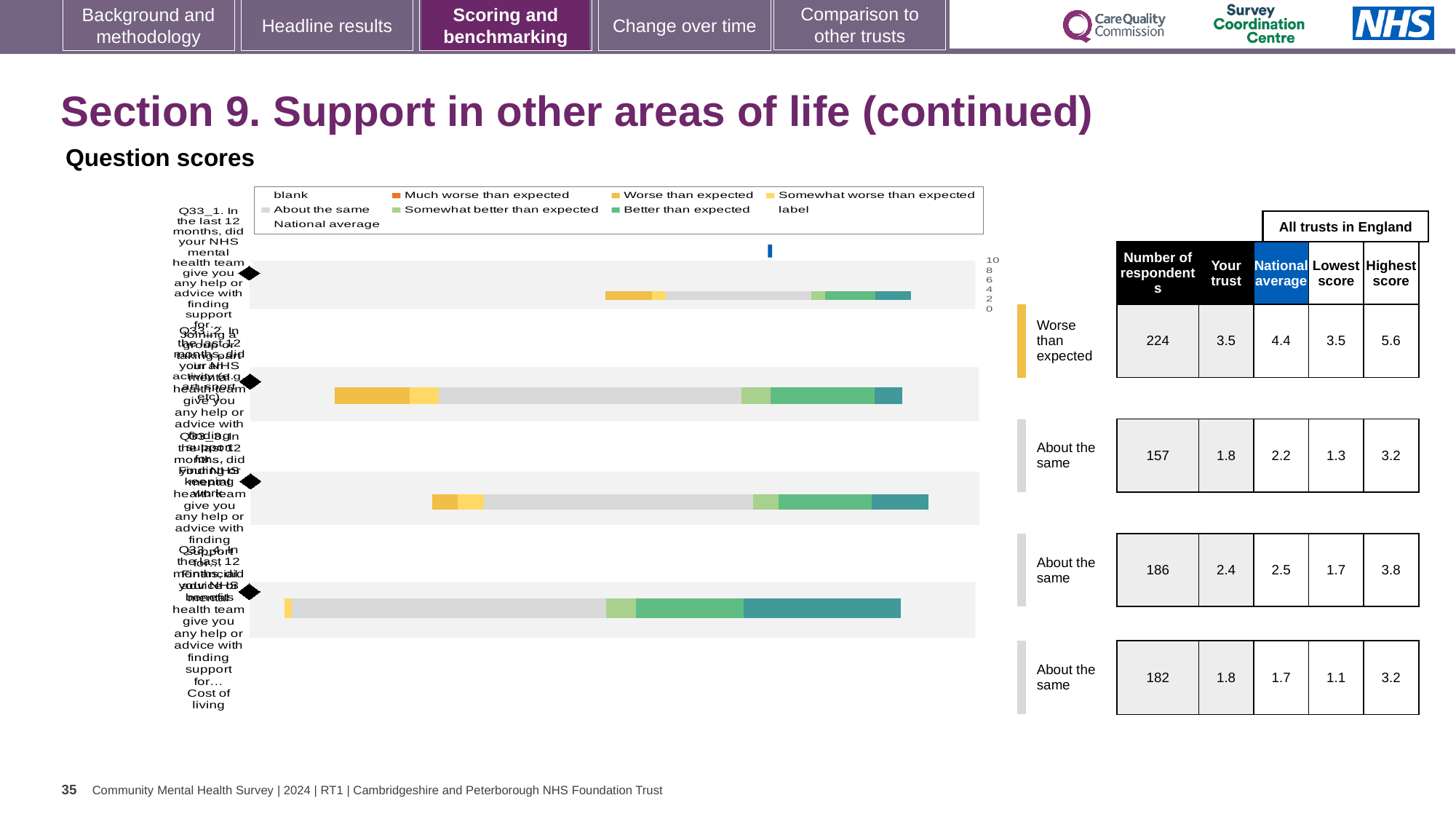
Which question has the lowest number of respondents? Q33_2 What kind of chart is used to show the question scores? bar chart What is the number of respondents for Q33_1? 224 What is the 'Your trust' score for Q33_2? 1.8 How many entries does the legend of the question scores chart list? 9 Which benchmark category is shown for Q33_1? Worse than expected How many questions (bars) are plotted in the question scores chart? 4 Which is larger for Q33_4: the 'Your trust' score or the national average? Your trust What is the highest score among all trusts in England for Q33_4 (Cost of living)? 3.2 Which question has the highest 'Your trust' score? Q33_1 What is the difference between the national average and the 'Your trust' score for Q33_1? 0.9 What is the national average score for Q33_3? 2.5